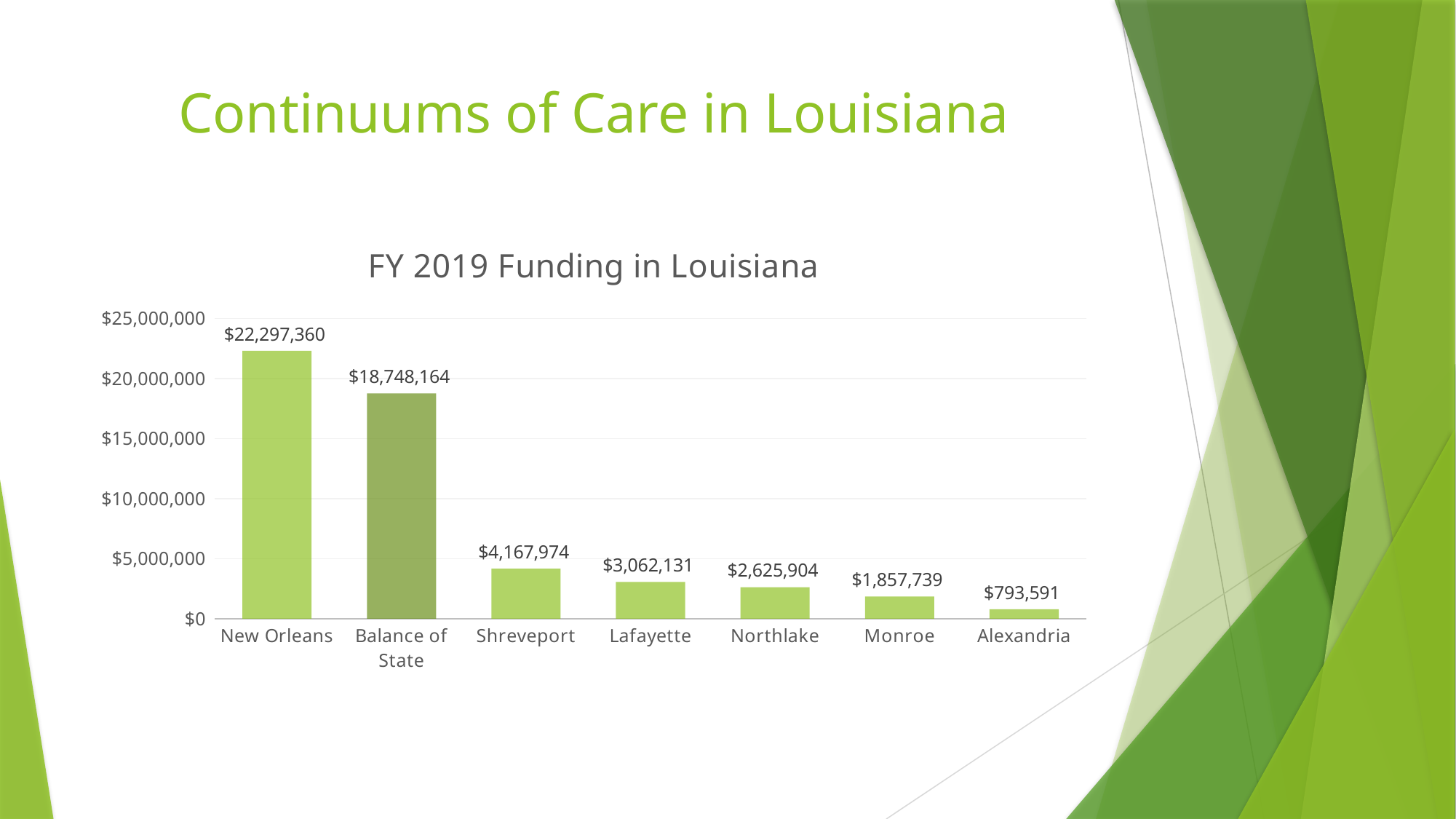
How many continuums of care are shown in the chart? 7 What is the difference in funding between Shreveport and Lafayette? $1,105,843 What is the FY 2019 funding value for Balance of State? $18,748,164 What is the FY 2019 funding value for New Orleans? $22,297,360 Do the funding values rise or fall from left to right across the chart? Fall Which received more FY 2019 funding, Monroe or Northlake? Northlake What is the FY 2019 funding value for Northlake? $2,625,904 What kind of chart is used to show FY 2019 Funding in Louisiana? Bar chart What is the FY 2019 funding value for Alexandria? $793,591 Which continuum of care received the lowest FY 2019 funding? Alexandria Which continuum of care received the highest FY 2019 funding? New Orleans What is the difference in funding between New Orleans and Balance of State? $3,549,196